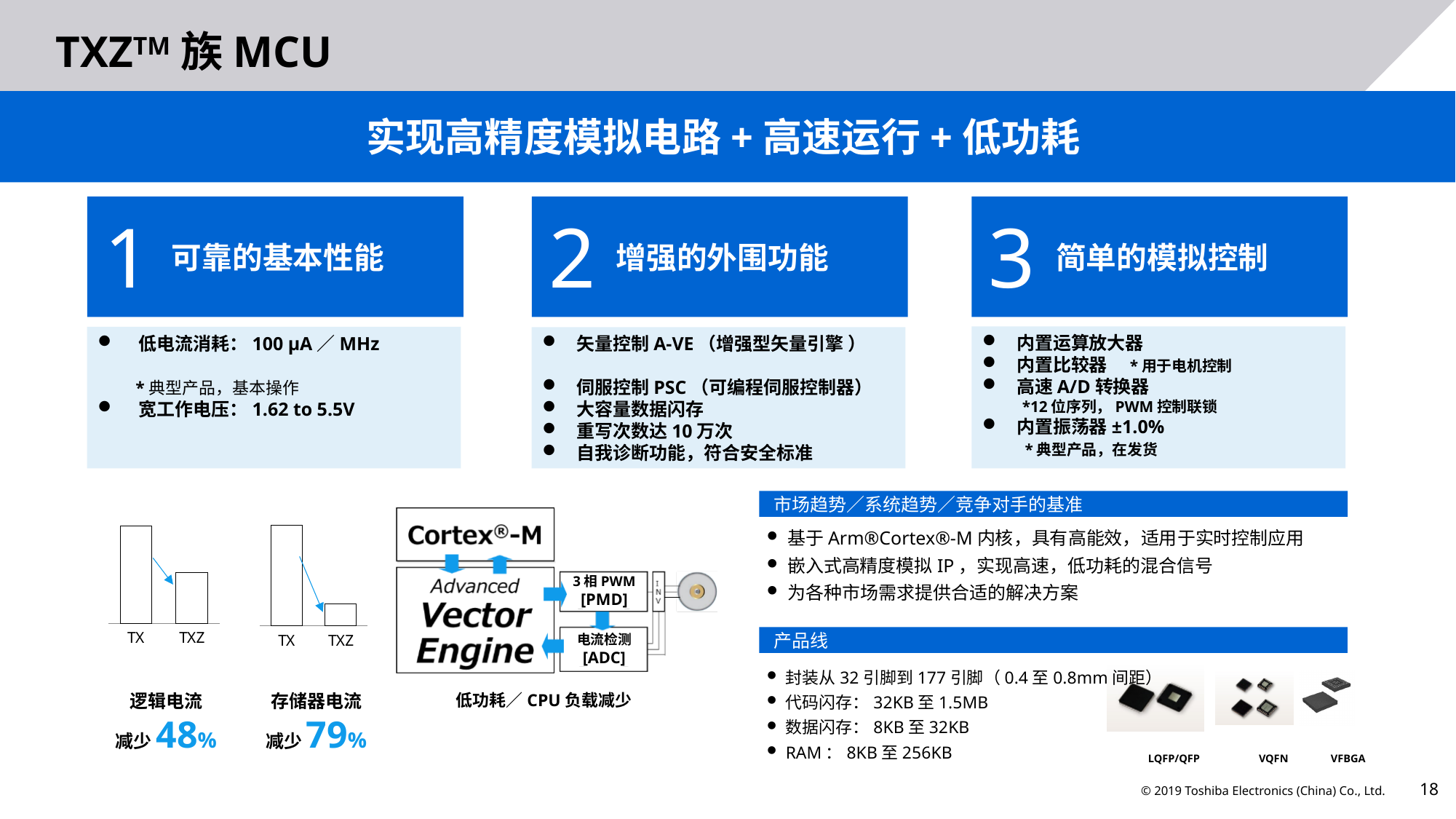
In the 逻辑电流 chart, which bar is taller, TX or TXZ? TX What reduction percentage is printed under the 逻辑电流 chart? 48% What are the two category labels on the x axis of the 逻辑电流 chart? TX and TXZ In the 存储器电流 chart, which category has the highest bar? TX In the 存储器电流 chart, which bar is taller, TX or TXZ? TX How many bars does the 逻辑电流 chart show? 2 Do the bars fall or rise from TX to TXZ in the 存储器电流 chart? fall Which chart shows the larger reduction, 逻辑电流 or 存储器电流? 存储器电流 What reduction percentage is printed under the 存储器电流 chart? 79% What kind of chart is the 逻辑电流 chart? bar chart In the 逻辑电流 chart, which category has the lowest bar? TXZ How many bars does the 存储器电流 chart show? 2